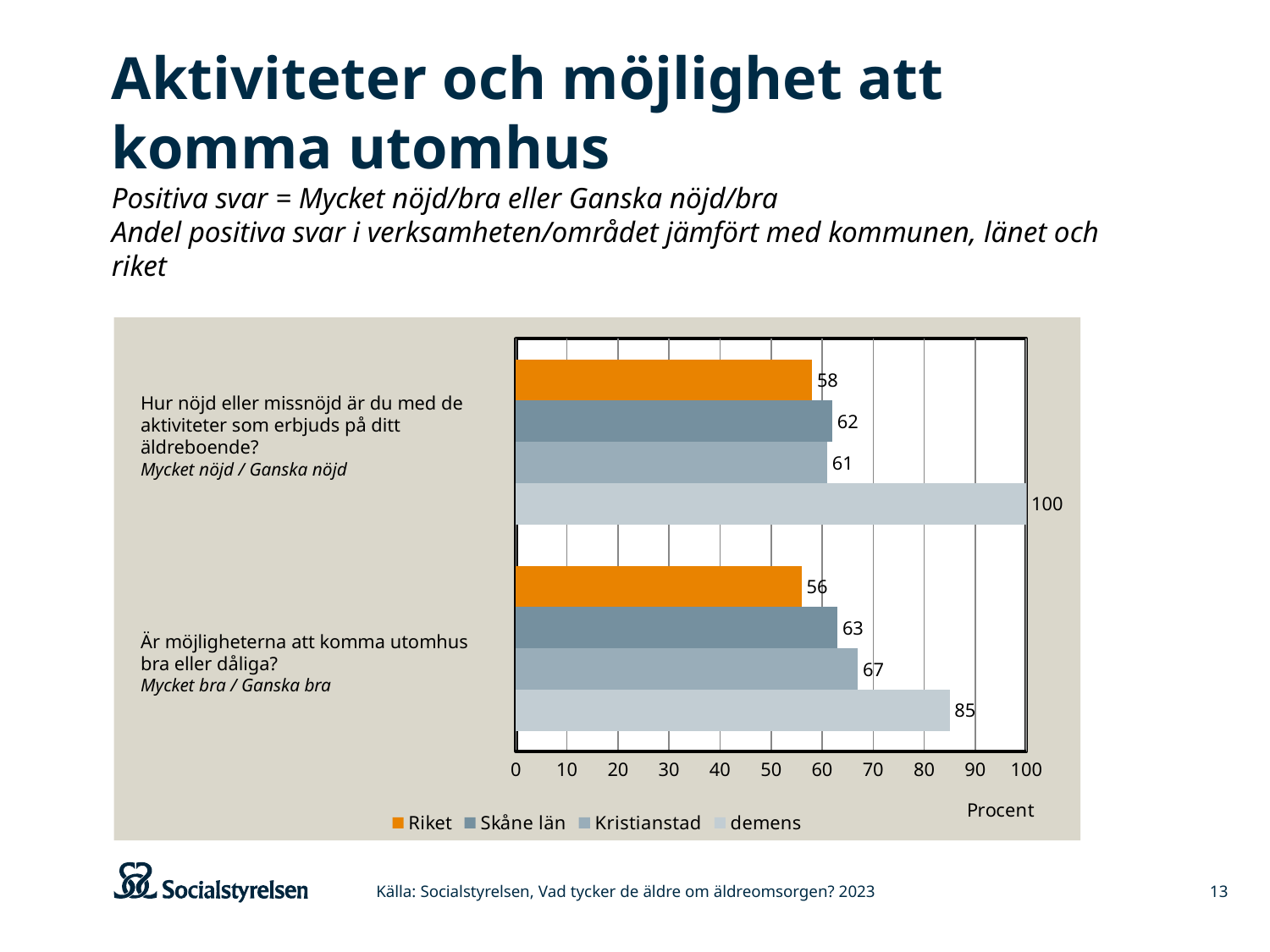
How many survey questions (categories) are shown on the chart? 2 What is the label of the x axis? Procent What kind of chart is shown on the slide? Bar chart What is the value for 'Riket' on the question about opportunities to get outdoors (Är möjligheterna att komma utomhus bra eller dåliga?)? 56 Which series has the lowest value on the question about satisfaction with activities offered at the care home? Riket What is the difference between the 'demens' value and the 'Riket' value on the question about opportunities to get outdoors? 29 What is the value for 'demens' on the question about satisfaction with activities offered at the care home (Hur nöjd eller missnöjd är du med de aktiviteter som erbjuds på ditt äldreboende?)? 100 What is the value for 'Kristianstad' on the question about opportunities to get outdoors? 67 How many series does the legend list? 4 What is the value for 'Skåne län' on the question about satisfaction with activities offered at the care home? 62 On the question about satisfaction with activities, which is larger: the value for 'Skåne län' or the value for 'Riket'? Skåne län Which series has the highest value on the question about opportunities to get outdoors? demens